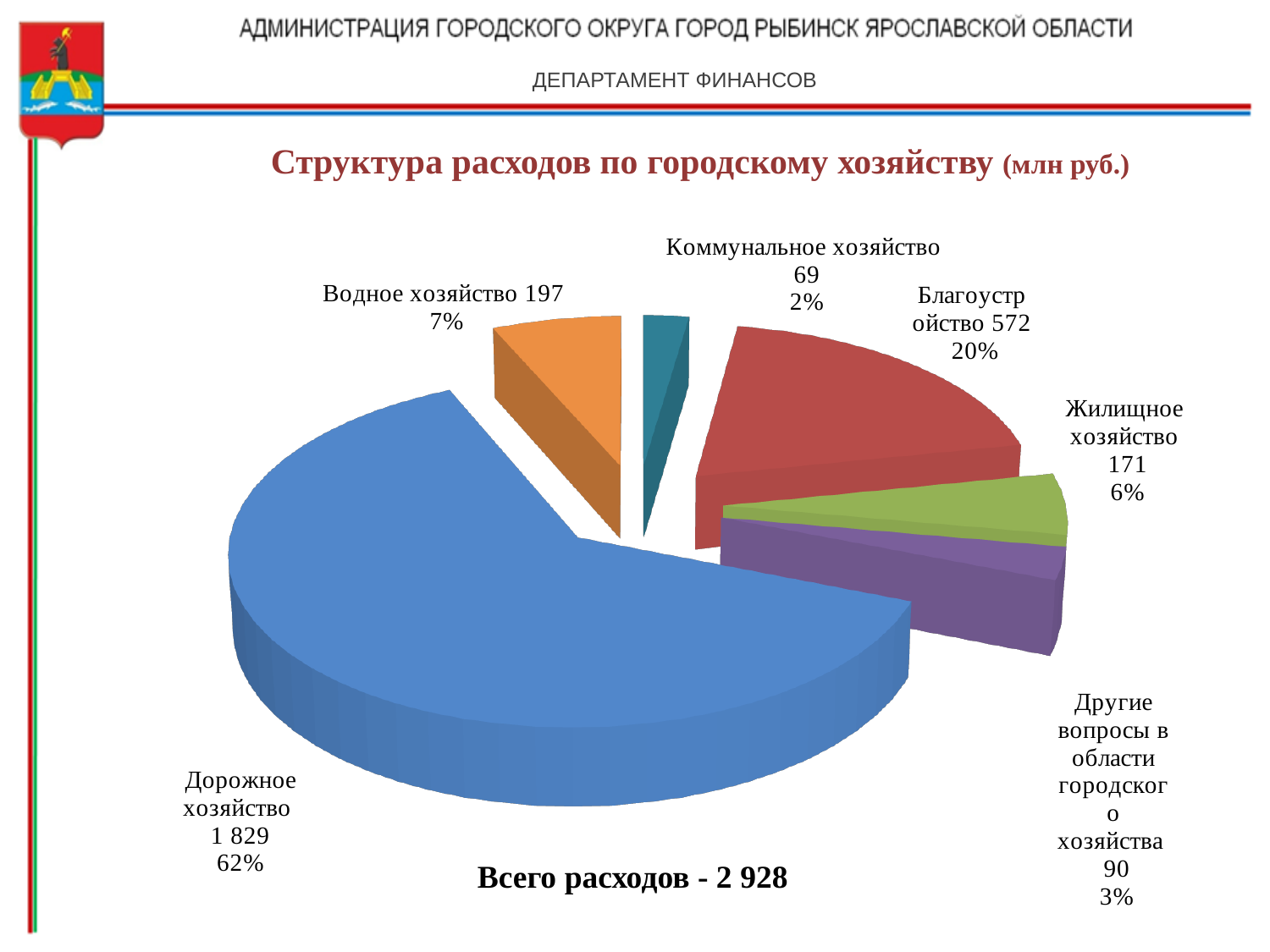
What is the difference between the values for Благоустройство and Жилищное хозяйство? 401 Which category has the largest value? Дорожное хозяйство What share of the pie does Жилищное хозяйство represent? 6% Which category has the smallest value? Коммунальное хозяйство How many slices does the pie chart have? 6 What is the value for Благоустройство? 572 What is the value for Дорожное хозяйство? 1 829 What is the value for Водное хозяйство? 197 Which is larger, the value for Водное хозяйство or the value for Другие вопросы в области городского хозяйства? Водное хозяйство What share of the pie does Дорожное хозяйство represent? 62% What kind of chart is shown on the slide? pie chart What is the value for Коммунальное хозяйство? 69